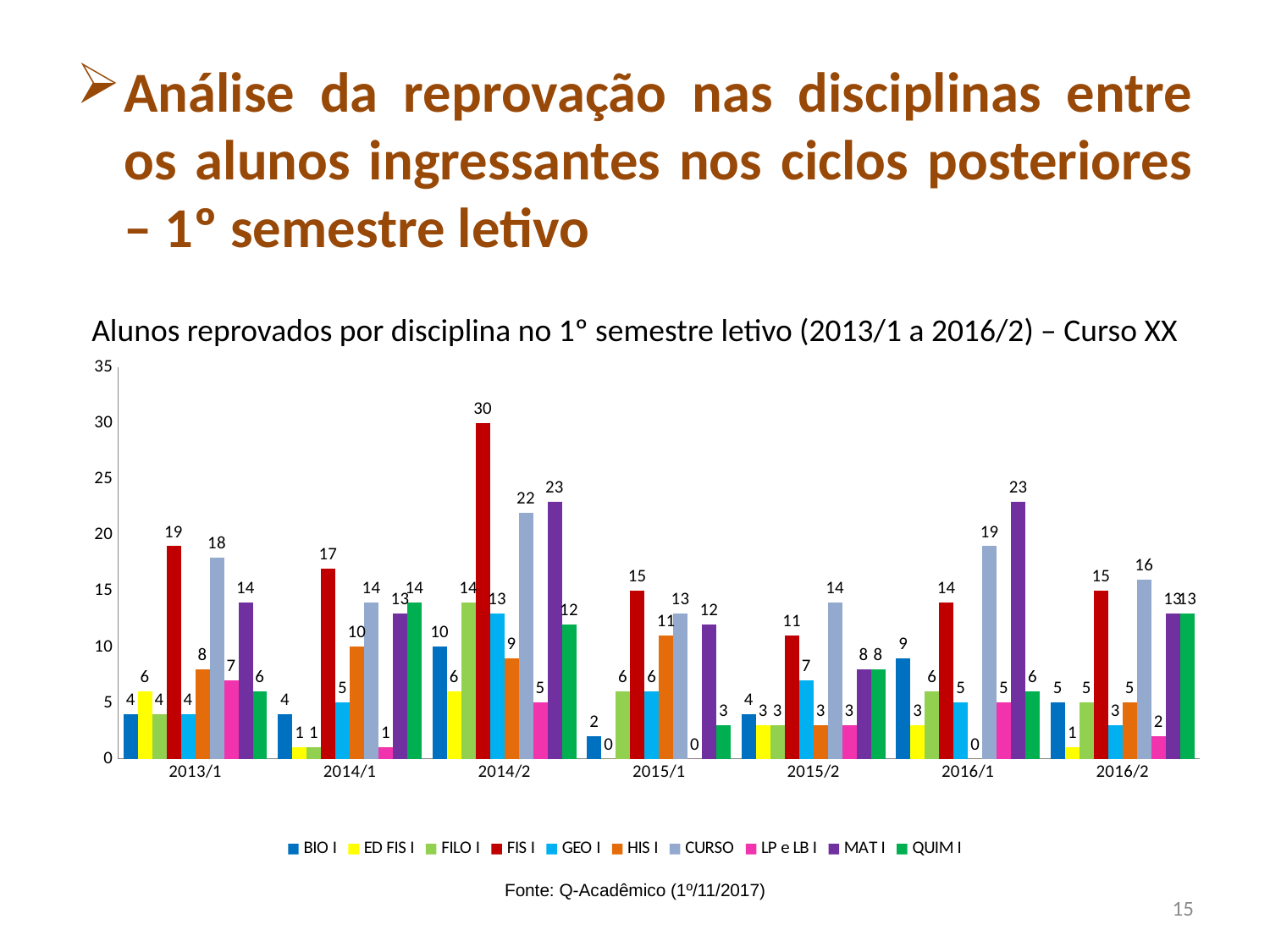
Which is larger in 2015/2: the value for CURSO or the value for FIS I? CURSO How many series does the legend list? 10 What type of chart is shown on the slide? bar chart How many semester categories are shown on the x axis? 7 What is the value for CURSO in 2016/1? 19 What is the value for FIS I in 2014/2? 30 Which series has the lowest value in 2016/1? HIS I What is the value for HIS I in 2015/1? 11 Which series has the highest value in 2013/1? FIS I Is the value for MAT I in 2016/1 greater or less than 20? greater What is the difference between the FIS I value in 2014/2 and the FIS I value in 2014/1? 13 What is the title of the chart? Alunos reprovados por disciplina no 1º semestre letivo (2013/1 a 2016/2) – Curso XX